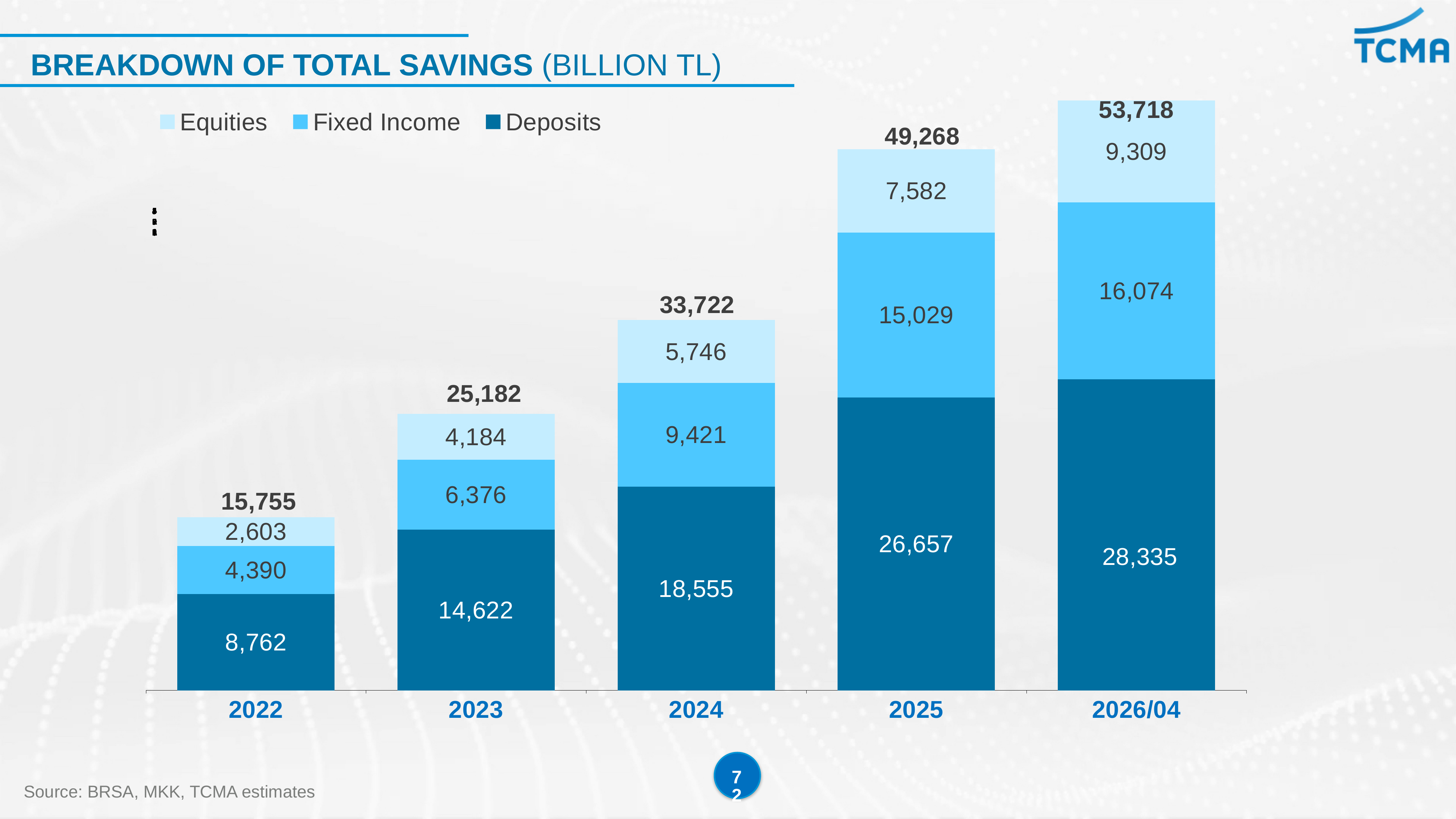
Do total savings rise or fall from 2022 to 2026/04? Rise What is the Deposits value for 2024? 18,555 Which year has the lowest Deposits value? 2022 How many series does the legend list? 3 What is the Fixed Income value for 2026/04? 16,074 What is the difference between the Fixed Income values for 2025 and 2024? 5,608 How many years are shown on the x axis? 5 What is the total savings shown for 2025? 49,268 What kind of chart is shown? Stacked bar chart Which year has the highest total savings? 2026/04 What is the Equities value for 2022? 2,603 Which is larger, the Equities value for 2023 or the Fixed Income value for 2023? Fixed Income (6,376)